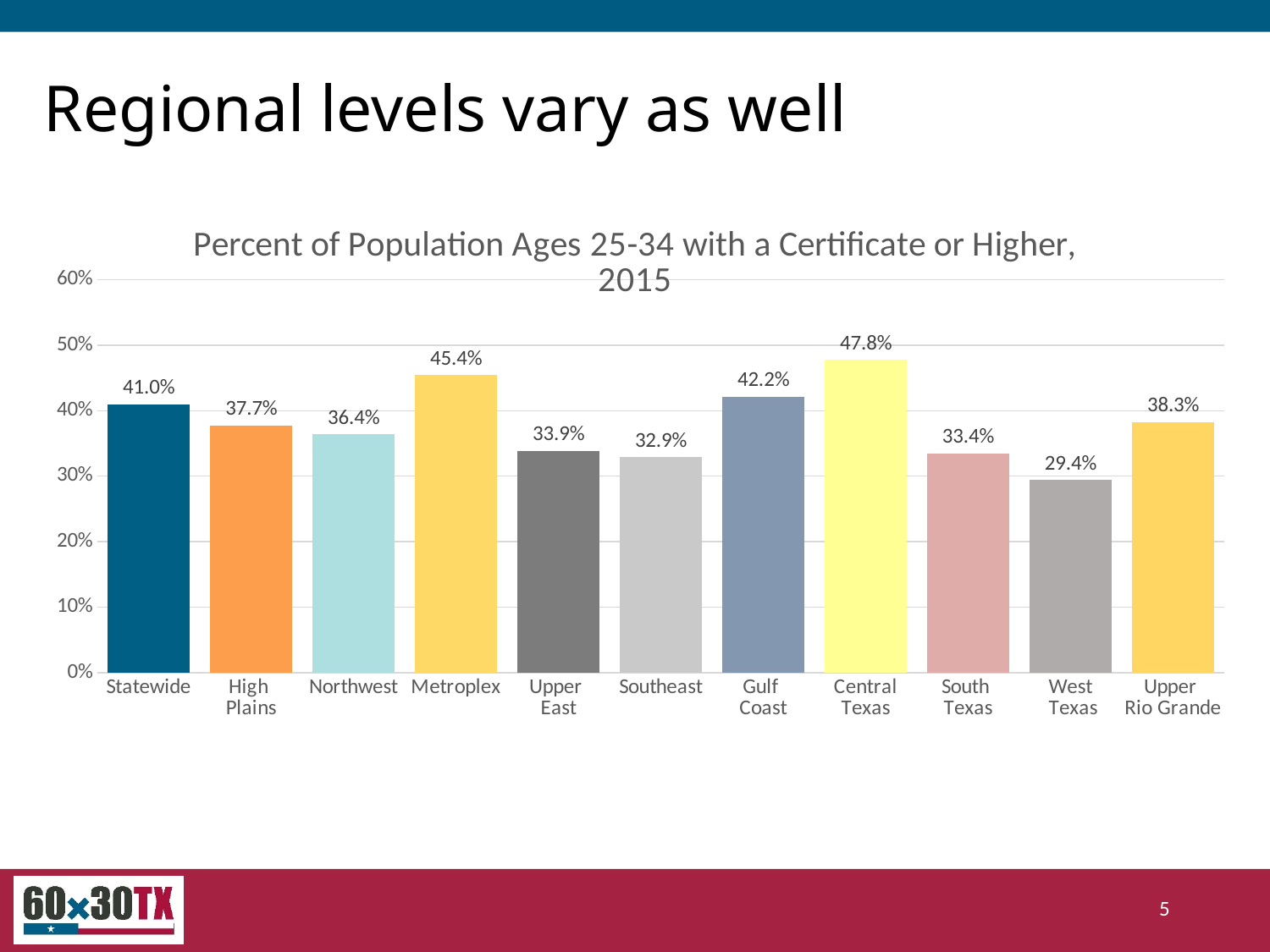
Is the value for South Texas greater or less than 40%? less What kind of chart is this? bar chart What is the value for Upper Rio Grande? 38.3% What is the title of the chart? Percent of Population Ages 25-34 with a Certificate or Higher, 2015 What is the value for Central Texas? 47.8% What is the difference between the Statewide value and the West Texas value? 11.6% What is the Statewide value? 41.0% Which is larger, the value for High Plains or the value for Northwest? High Plains Which region has the highest value? Central Texas Which region has the lowest value? West Texas How many categories are shown on the x axis? 11 What is the difference between the Metroplex and Gulf Coast values? 3.2%